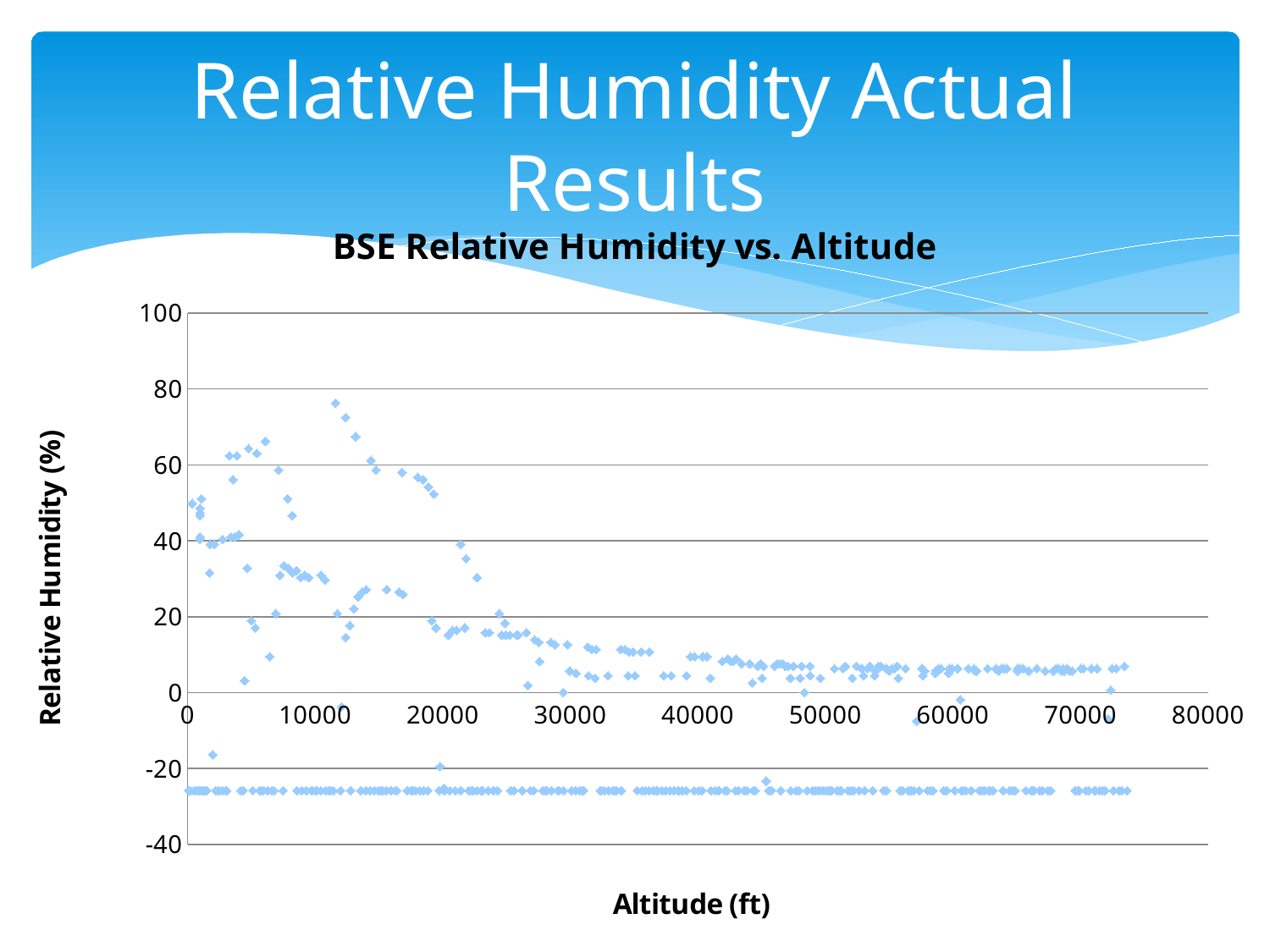
What kind of chart is shown on the slide? Scatter chart In the upper cluster of points, does relative humidity generally rise or fall as altitude increases beyond about 20000 ft? fall Is the relative humidity of the flat band of points running along the bottom of the chart greater or less than -20? less Is the highest relative humidity value plotted on the chart greater or less than 80? less What is the title of the chart? BSE Relative Humidity vs. Altitude Is the highest relative humidity value plotted on the chart greater or less than 60? greater What is the label of the vertical axis of the chart? Relative Humidity (%)